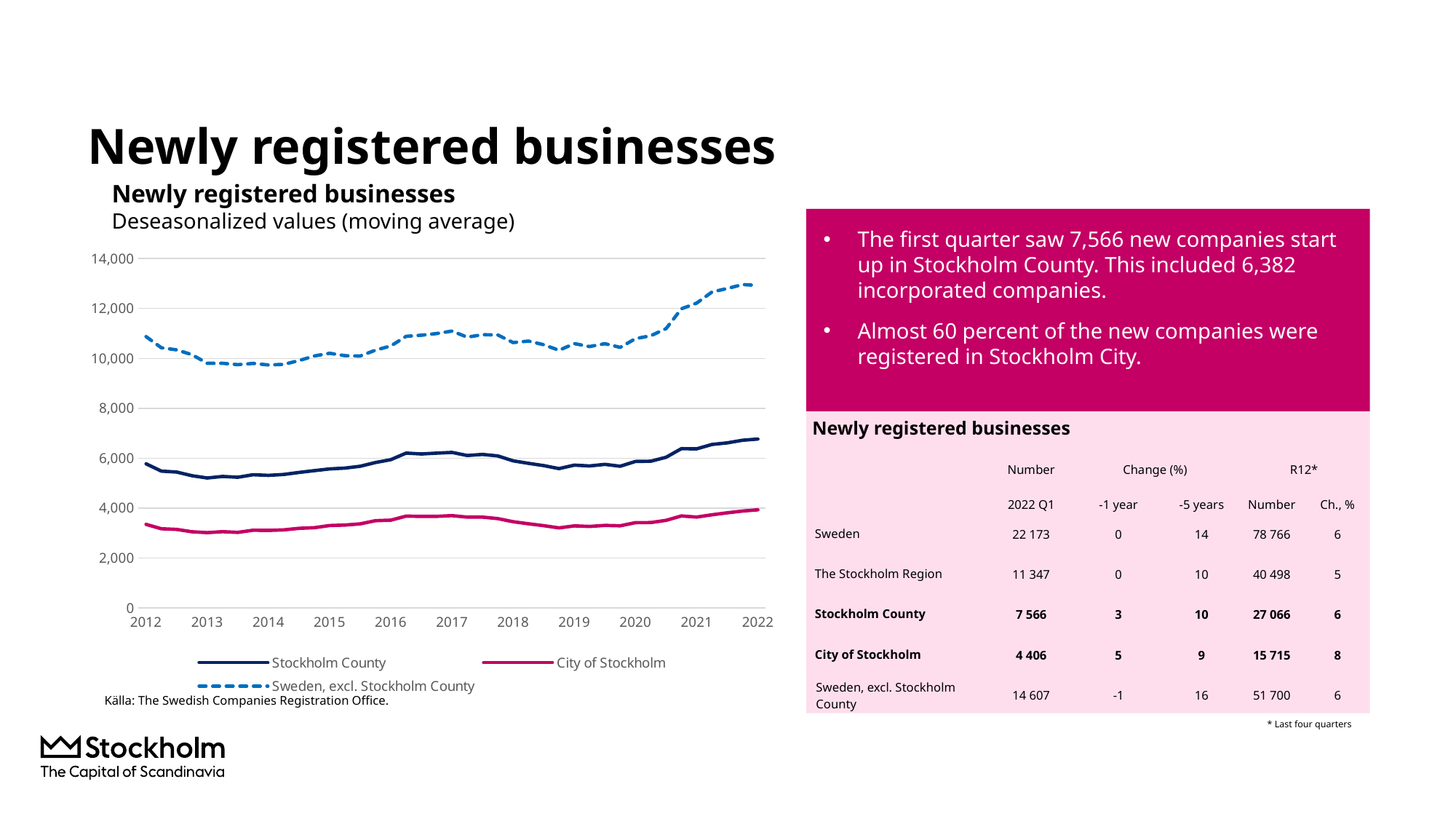
Does the Sweden, excl. Stockholm County series rise or fall between 2020 and 2022? rise What is the subtitle of the chart below 'Newly registered businesses'? Deseasonalized values (moving average) Is the value for Sweden, excl. Stockholm County at 2022 greater or less than 12,000? greater What kind of chart is shown on the slide? line chart Which is larger at 2022: the value for Stockholm County or the value for City of Stockholm? Stockholm County Is the value for Stockholm County at 2022 greater or less than 8,000? less How many series does the chart legend list? 3 Which series has the lowest values throughout the chart? City of Stockholm Which series has the highest values throughout the chart? Sweden, excl. Stockholm County Is the value for City of Stockholm at 2012 greater or less than 4,000? less Which series is plotted with a dashed line? Sweden, excl. Stockholm County